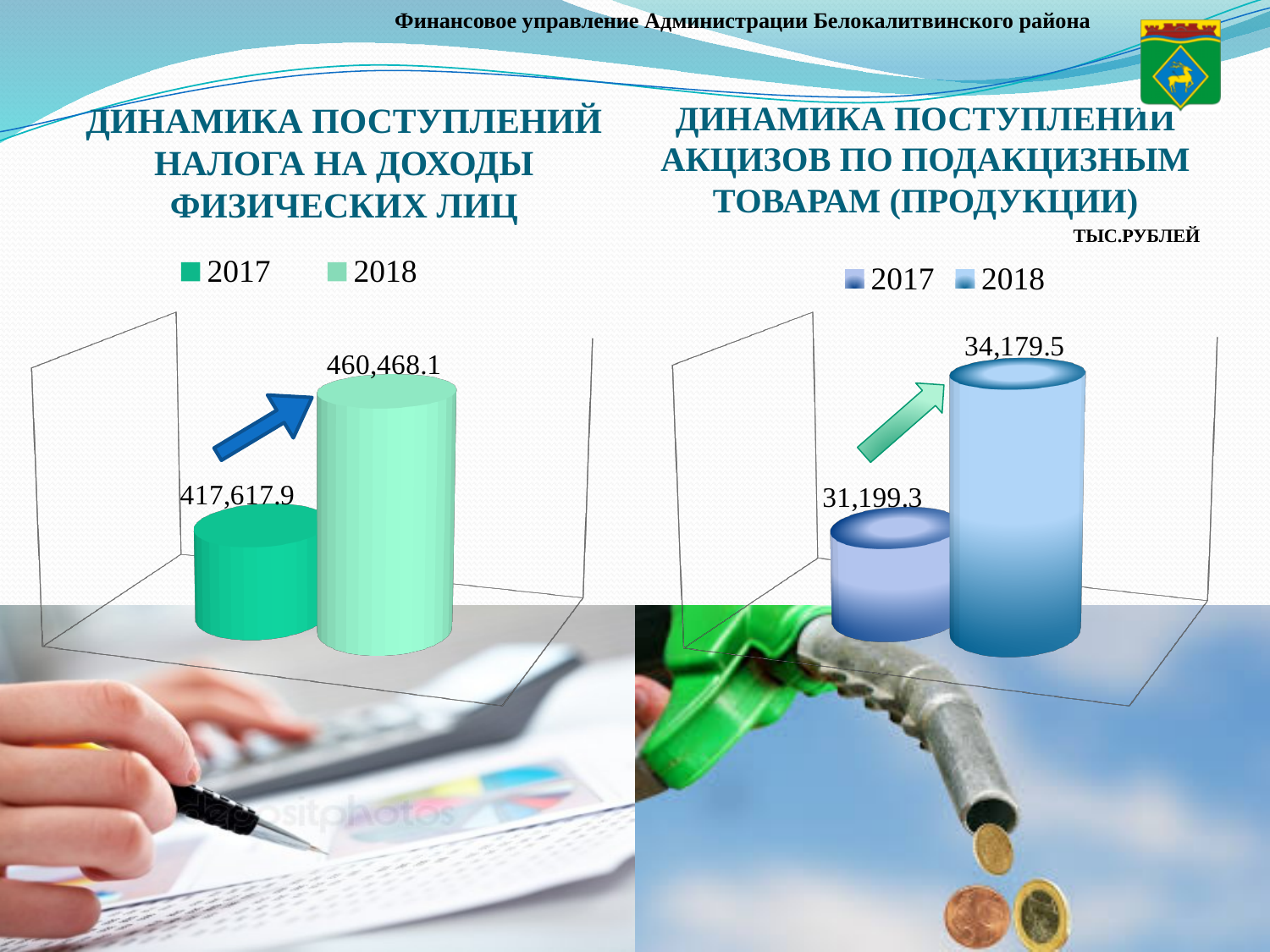
In the left chart (ДИНАМИКА ПОСТУПЛЕНИЙ НАЛОГА НА ДОХОДЫ ФИЗИЧЕСКИХ ЛИЦ), what is the value for 2018? 460,468.1 In the left chart, by how much does the 2018 value exceed the 2017 value? 42,850.2 What kind of chart is the right chart? bar chart What unit is indicated for the right chart? ТЫС.РУБЛЕЙ In the left chart (ДИНАМИКА ПОСТУПЛЕНИЙ НАЛОГА НА ДОХОДЫ ФИЗИЧЕСКИХ ЛИЦ), what is the value for 2017? 417,617.9 In the right chart (ДИНАМИКА ПОСТУПЛЕНИЙ АКЦИЗОВ ПО ПОДАКЦИЗНЫМ ТОВАРАМ), what is the value for 2018? 34,179.5 In the right chart (ДИНАМИКА ПОСТУПЛЕНИЙ АКЦИЗОВ ПО ПОДАКЦИЗНЫМ ТОВАРАМ), what is the value for 2017? 31,199.3 In the right chart, which year has the lower value? 2017 In the right chart, is the value for 2018 larger or smaller than the value for 2017? larger How many series does the legend of the left chart list? 2 In the left chart, which year has the higher value? 2018 In the right chart, what is the difference between the 2018 and 2017 values? 2,980.2